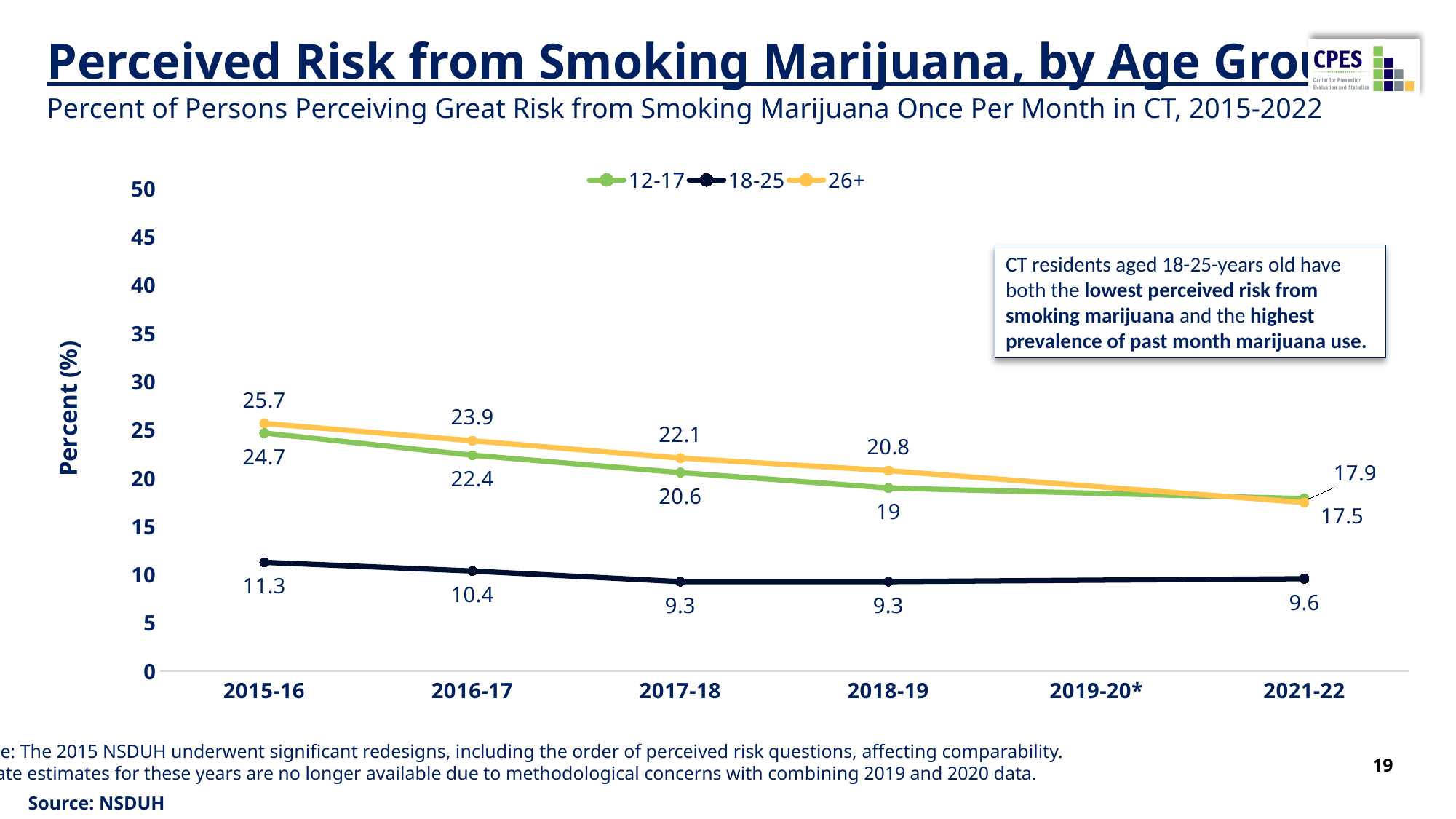
Does the value for the 26+ age group rise or fall from 2015-16 to 2021-22? fall What is the difference between the 26+ and 12-17 values in 2015-16? 1 How many series does the legend list? 3 Which age group has the highest value in 2016-17? 26+ What is the value for the 12-17 age group in 2018-19? 19 What is the value for the 18-25 age group in 2016-17? 10.4 What is the label of the y axis? Percent (%) How many periods are labeled on the x axis? 6 Which age group has the lowest value in 2017-18? 18-25 Which is larger in 2018-19, the value for 26+ or the value for 18-25? 26+ What is the value for the 26+ age group in 2015-16? 25.7 What type of chart is shown on the slide? line chart